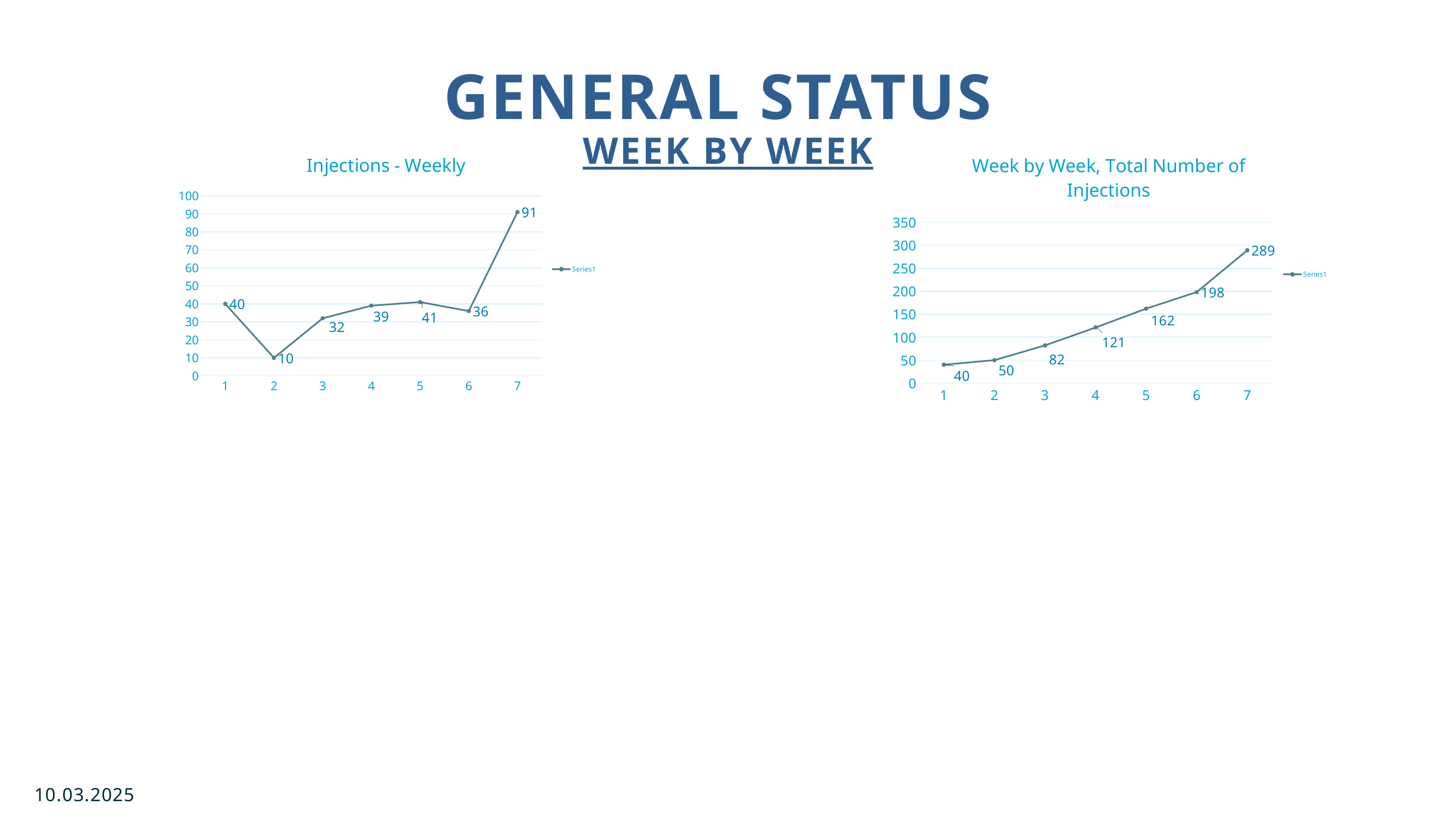
In the 'Week by Week, Total Number of Injections' chart, do the values rise or fall from week 1 to week 7? rise In the 'Injections - Weekly' chart, what is the value for week 7? 91 In the 'Week by Week, Total Number of Injections' chart, what is the difference between the values for week 7 and week 6? 91 How many series does the legend of the 'Week by Week, Total Number of Injections' chart list? 1 In the 'Injections - Weekly' chart, how many weeks are plotted? 7 In the 'Injections - Weekly' chart, what is the difference between the values for week 7 and week 6? 55 In the 'Injections - Weekly' chart, which week has the highest value? 7 In the 'Week by Week, Total Number of Injections' chart, is the value for week 5 greater or less than 150? greater In the 'Injections - Weekly' chart, which is larger, the value for week 1 or week 3? week 1 What kind of chart is 'Injections - Weekly'? line chart In the 'Injections - Weekly' chart, which week has the lowest value? 2 In the 'Week by Week, Total Number of Injections' chart, what is the value for week 4? 121